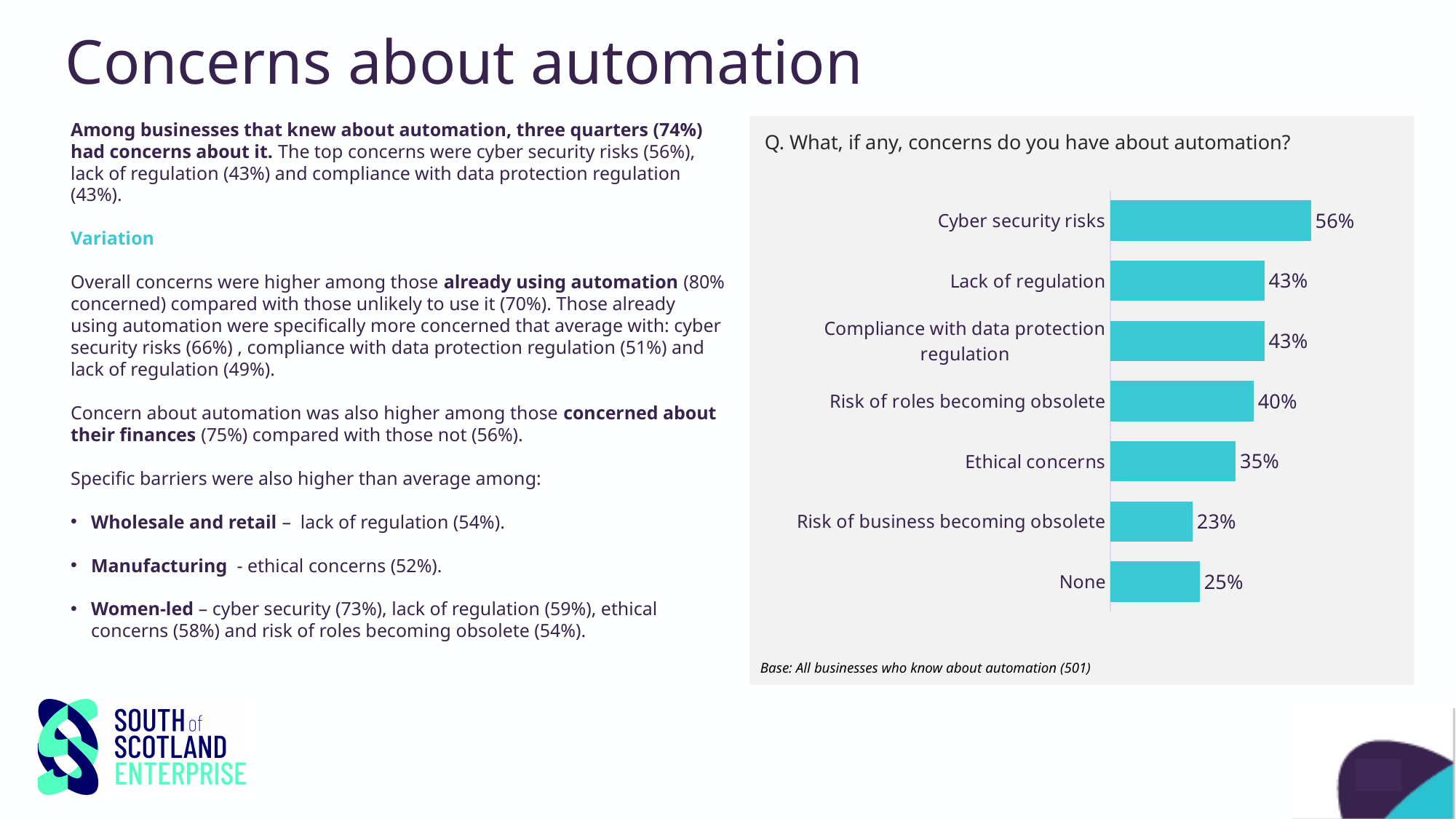
What type of chart is used to show the concerns about automation? Bar chart Which is larger: the value for 'None' or the value for 'Risk of business becoming obsolete'? None What is the difference in percentage points between 'Cyber security risks' and 'Lack of regulation'? 13 What is the value for 'Risk of business becoming obsolete'? 23% What is the difference in percentage points between 'Risk of roles becoming obsolete' and 'Ethical concerns'? 5 What is the value shown for 'Ethical concerns'? 35% What percentage of businesses cited cyber security risks as a concern about automation? 56% Which category has the lowest percentage in the chart? Risk of business becoming obsolete What is the base (number of respondents) stated below the chart? All businesses who know about automation (501) What percentage of businesses said they had no concerns ('None') about automation? 25% How many categories are shown in the chart? 7 Which concern has the highest percentage in the chart? Cyber security risks